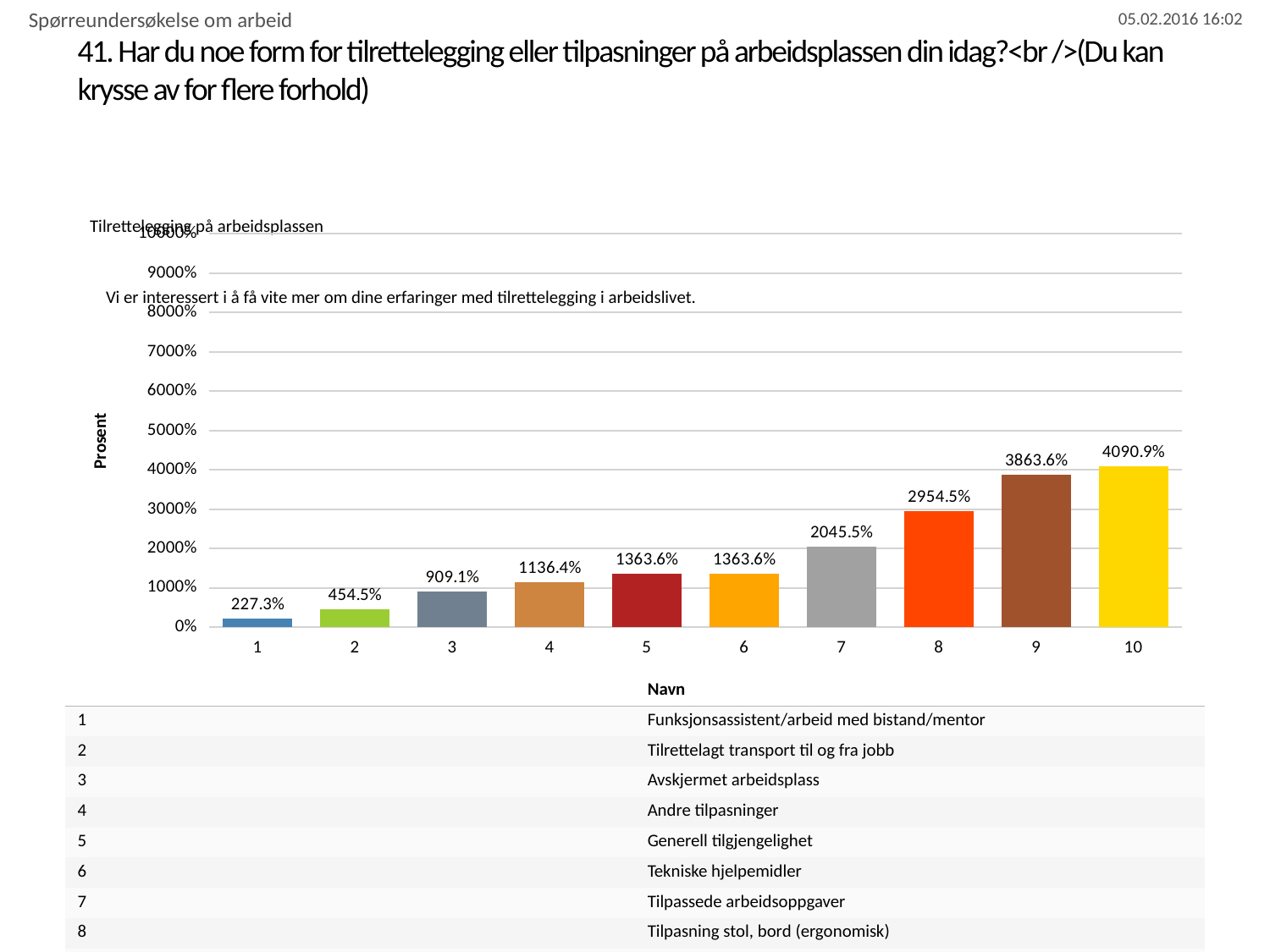
Which is larger, the value for category 3 or the value for category 4? category 4 What is the label of the vertical axis? Prosent Which category has the highest value? 10 What is the value for category 1? 227.3% What is the value for category 9? 3863.6% What is the difference between the values for category 10 and category 8? 1136.4% What is the value for category 7? 2045.5% Is the value for category 8 greater or less than 3000%? less Do the values rise or fall from category 1 to category 10? rise How many bars are plotted in the chart? 10 What type of chart is shown on the slide? bar chart Which category has the lowest value? 1